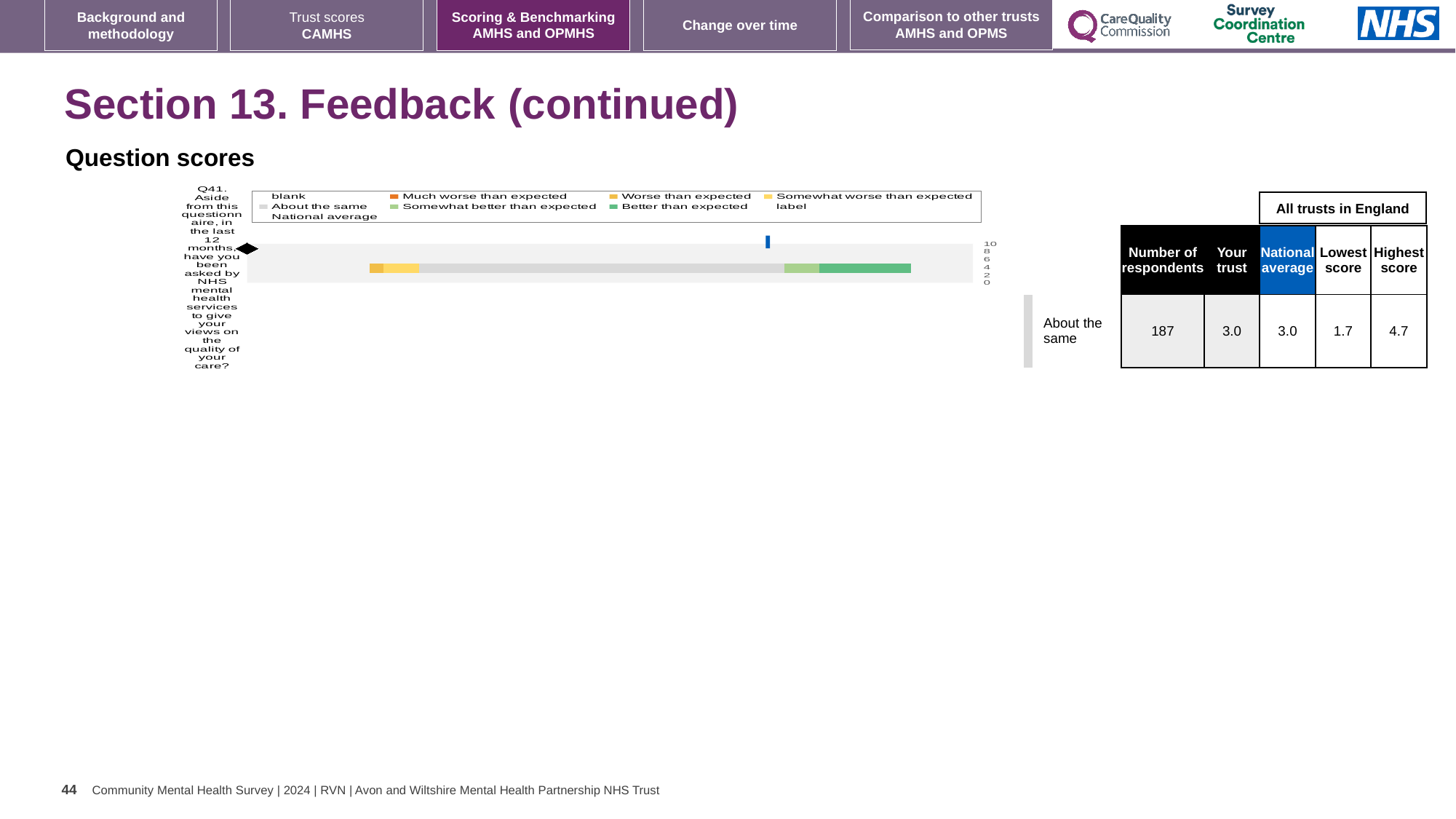
How many question categories are plotted in the chart? 1 What is the difference between the highest score and the 'Your trust' score for Q41? 1.7 What is the difference between the highest score and the lowest score for Q41? 3.0 What is the number of respondents for Q41? 187 What is the 'Your trust' score for Q41? 3.0 What is the lowest score among all trusts in England for Q41? 1.7 What kind of chart is shown on the slide? bar chart What is the highest score among all trusts in England for Q41? 4.7 What is the national average score for Q41? 3.0 What is the benchmark category shown next to the chart for Q41? About the same Which question number is plotted in the chart? Q41 Which is larger for Q41, the highest score or the lowest score? highest score